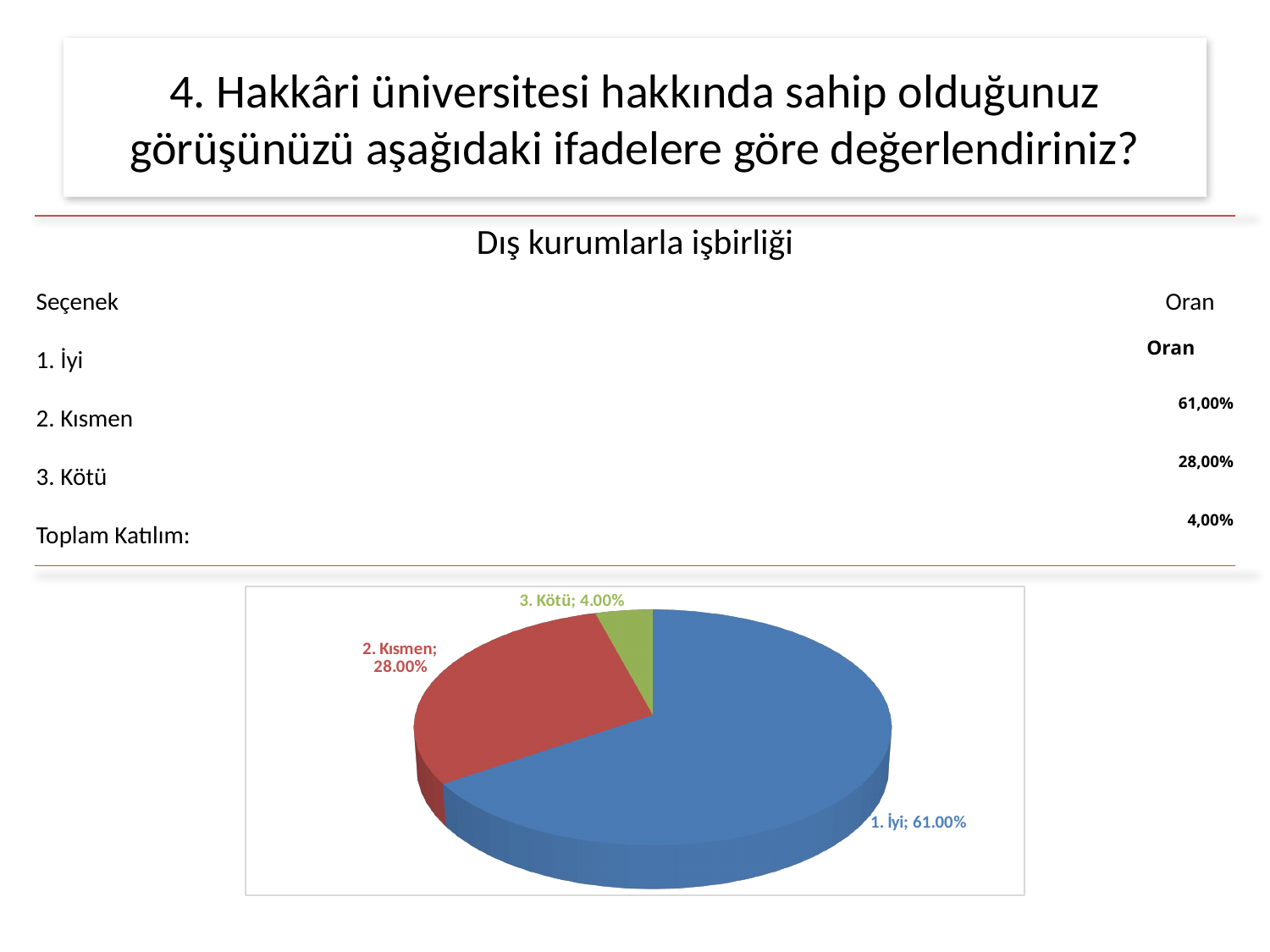
Which slice of the pie chart is the smallest? 3. Kötü Which slice of the pie chart is the largest? 1. İyi What colour is the "1. İyi" slice in the pie chart? blue What is the difference between the values for "2. Kısmen" and "3. Kötü" in the pie chart? 24.00% How many slices does the pie chart have? 3 What colour is the "3. Kötü" slice in the pie chart? green What kind of chart is shown on the slide? pie chart Which is larger in the pie chart, "2. Kısmen" or "3. Kötü"? 2. Kısmen What is the difference between the values for "1. İyi" and "2. Kısmen" in the pie chart? 33.00% What is the value shown for "1. İyi" in the pie chart? 61.00% What is the value shown for "3. Kötü" in the pie chart? 4.00% What is the value shown for "2. Kısmen" in the pie chart? 28.00%